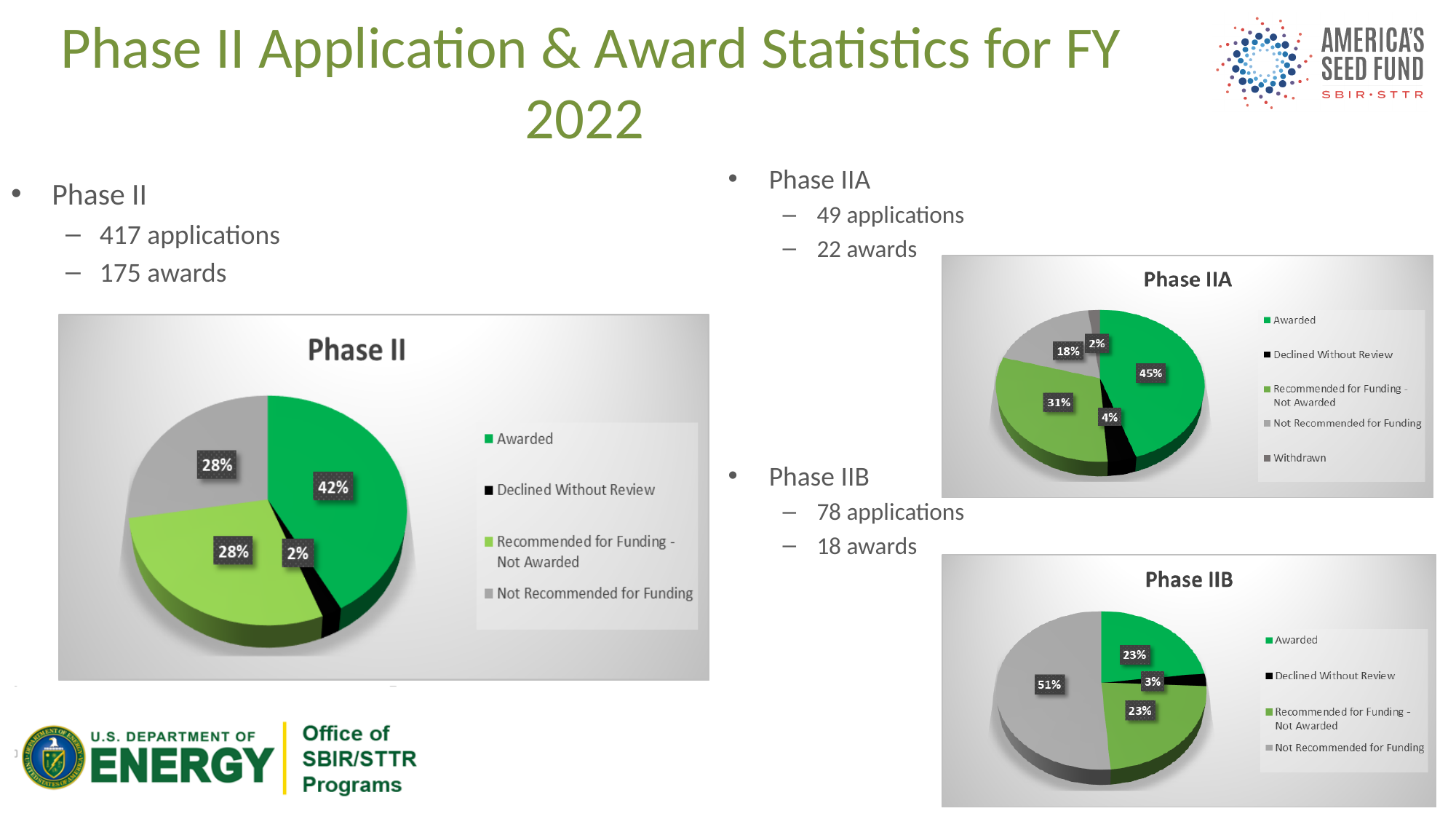
In the Phase II chart, what percentage is Declined Without Review? 2% In the Phase IIA chart, what percentage is Recommended for Funding - Not Awarded? 31% In the Phase II chart, which category has the largest slice? Awarded In the Phase IIB chart, what percentage is Declined Without Review? 3% In the Phase IIA chart, what is the difference between the Awarded share and the Not Recommended for Funding share? 27% In the Phase IIB chart, which category has the largest slice? Not Recommended for Funding In the Phase IIA chart, how many slices does the pie have? 5 In the Phase IIA chart, what percentage is Withdrawn? 2% What type of chart is the Phase IIB chart? Pie chart Which is larger: the Awarded share in the Phase IIA chart or the Awarded share in the Phase IIB chart? Phase IIA In the Phase II chart, how many categories does the legend list? 4 In the Phase II chart, what share of the pie is Awarded? 42%